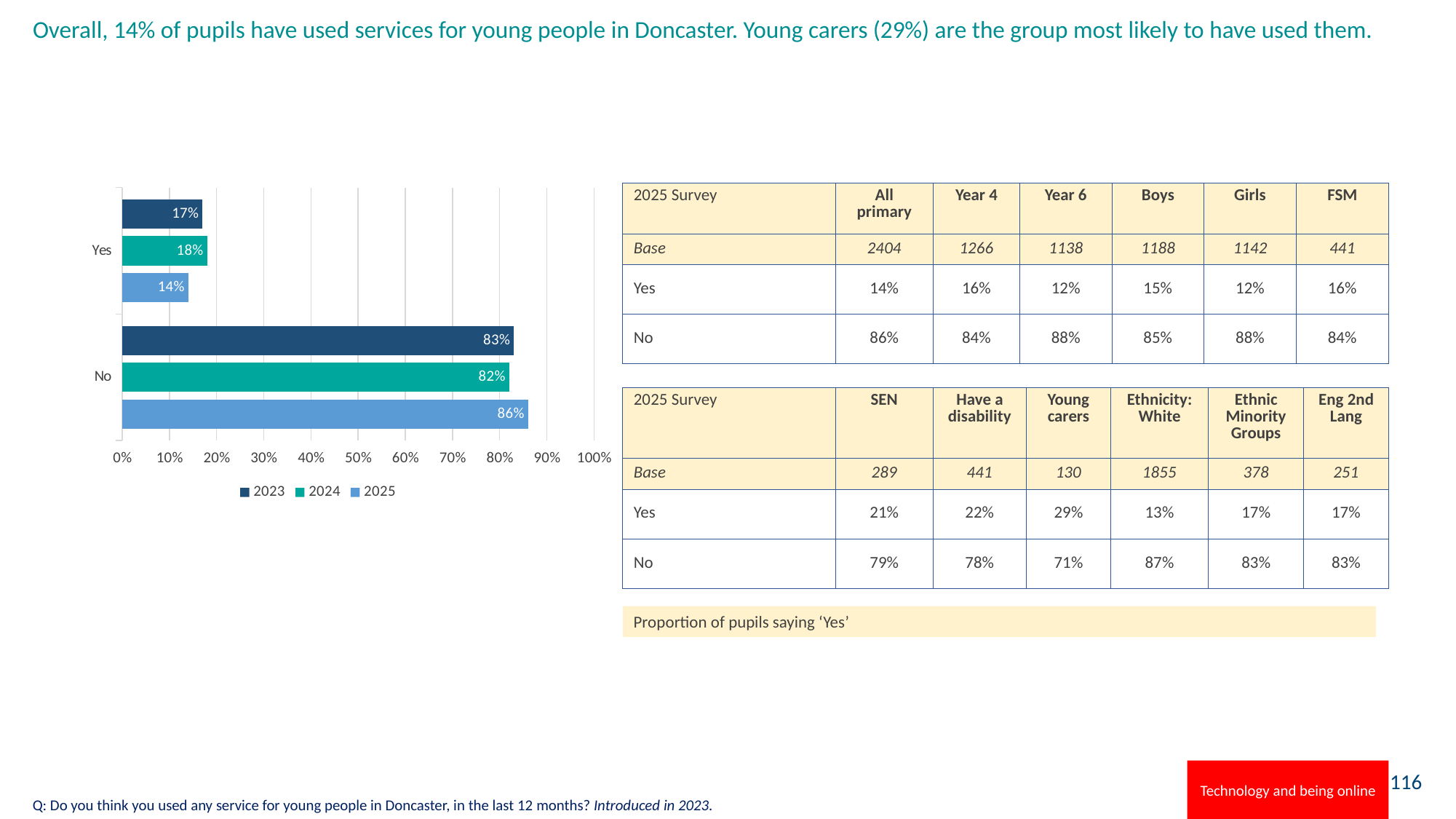
What percentage of pupils answered 'No' in 2023? 83% What is the difference between the 'No' value in 2025 and the 'No' value in 2024? 4% What percentage of pupils answered 'Yes' in 2025? 14% Which year has the lowest 'Yes' value? 2025 How many response categories are shown on the chart? 2 Which year has the highest 'No' value? 2025 How many series does the legend list? 3 Is the 'No' value for 2024 greater or less than 80%? greater Which series is shown in the darkest blue colour in the chart? 2023 Which is larger: the 'Yes' value for 2023 or the 'Yes' value for 2024? 2024 What kind of chart is shown on the slide? Bar chart What percentage of pupils answered 'Yes' in 2024? 18%